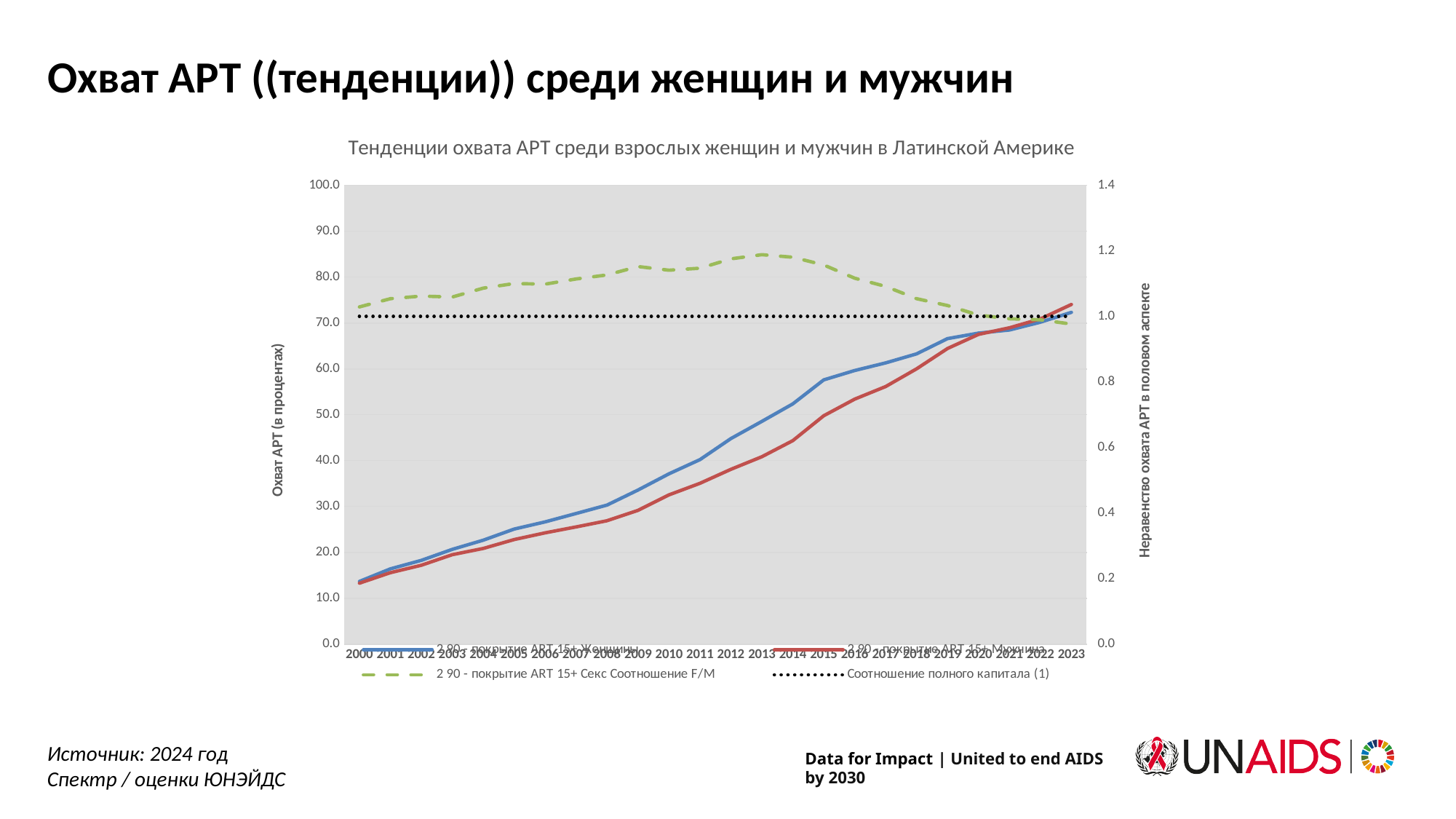
In which year is ART coverage for men (2 90 - покрытие ART 15+ Мужчина) lowest? 2000 Is the ART coverage for women in 2015 greater or less than 50.0? greater In which year is ART coverage for women highest? 2023 In 2010, which is higher: ART coverage for women or for men? women What kind of chart is shown on the slide? line chart Is the ART coverage for men in 2010 greater or less than 40.0? less On the right axis, is the F/M sex ratio (2 90 - покрытие ART 15+ Секс Соотношение F/M) in 2013 greater or less than 1.0? greater How many series does the chart legend list? 4 How many years are shown along the x axis of the chart? 24 What is the title of the chart? Тенденции охвата АРТ среди взрослых женщин и мужчин в Латинской Америке Does the ART coverage for women (2 90 - покрытие ART 15+ Женщины) rise or fall from 2000 to 2023? rise